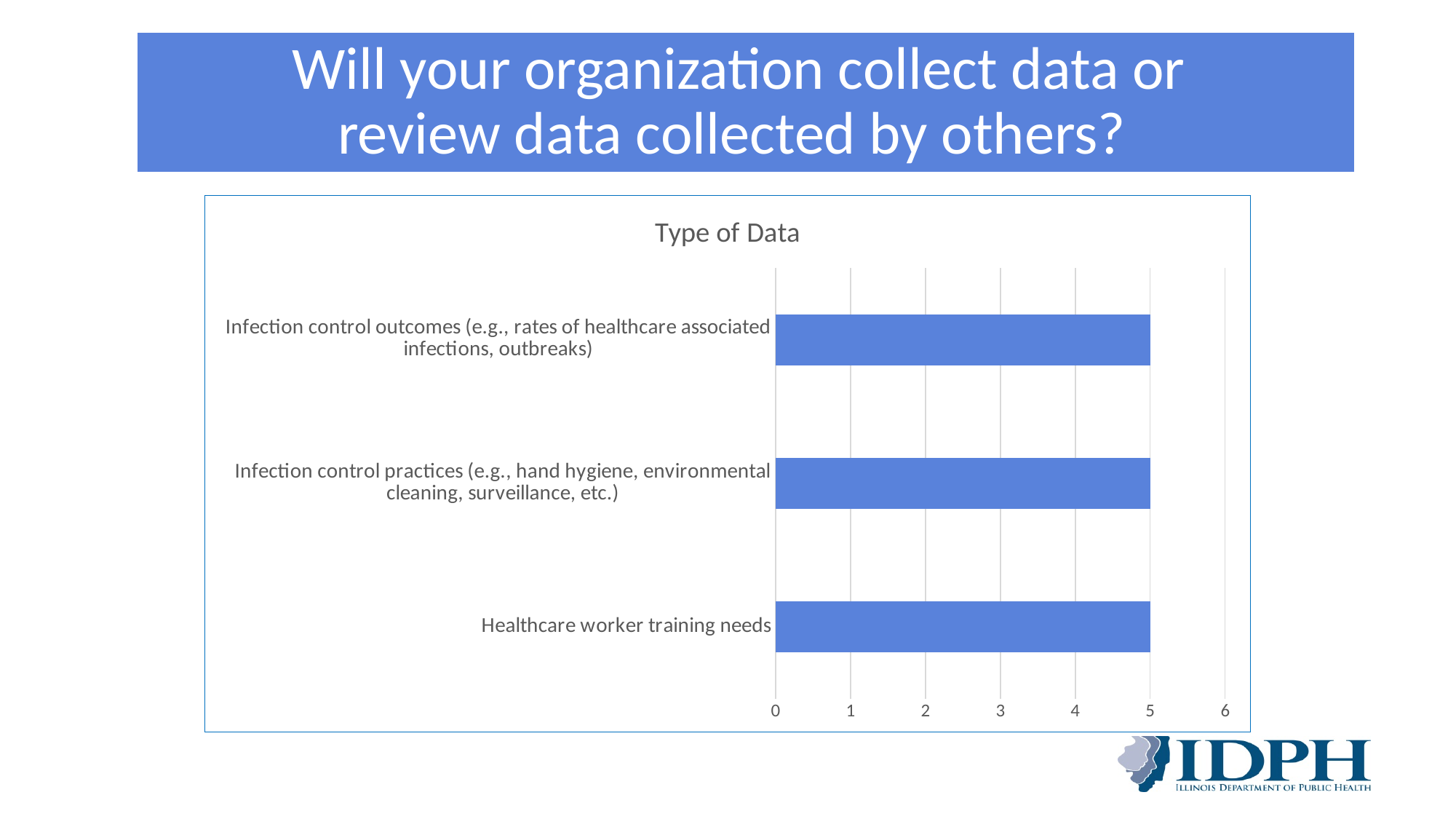
What type of chart is shown on the slide? bar chart What is the difference between the value for Infection control outcomes and the value for Healthcare worker training needs? 0 Is the value for Healthcare worker training needs greater or less than 4? greater What is the value for Infection control practices (e.g., hand hygiene, environmental cleaning, surveillance, etc.)? 5 What is the highest value shown on the x axis? 6 What is the value for Healthcare worker training needs? 5 Is the value for Infection control outcomes (e.g., rates of healthcare associated infections, outbreaks) greater or less than 6? less What is the title of the chart? Type of Data How many categories are shown in the chart? 3 What is the value for Infection control outcomes (e.g., rates of healthcare associated infections, outbreaks)? 5